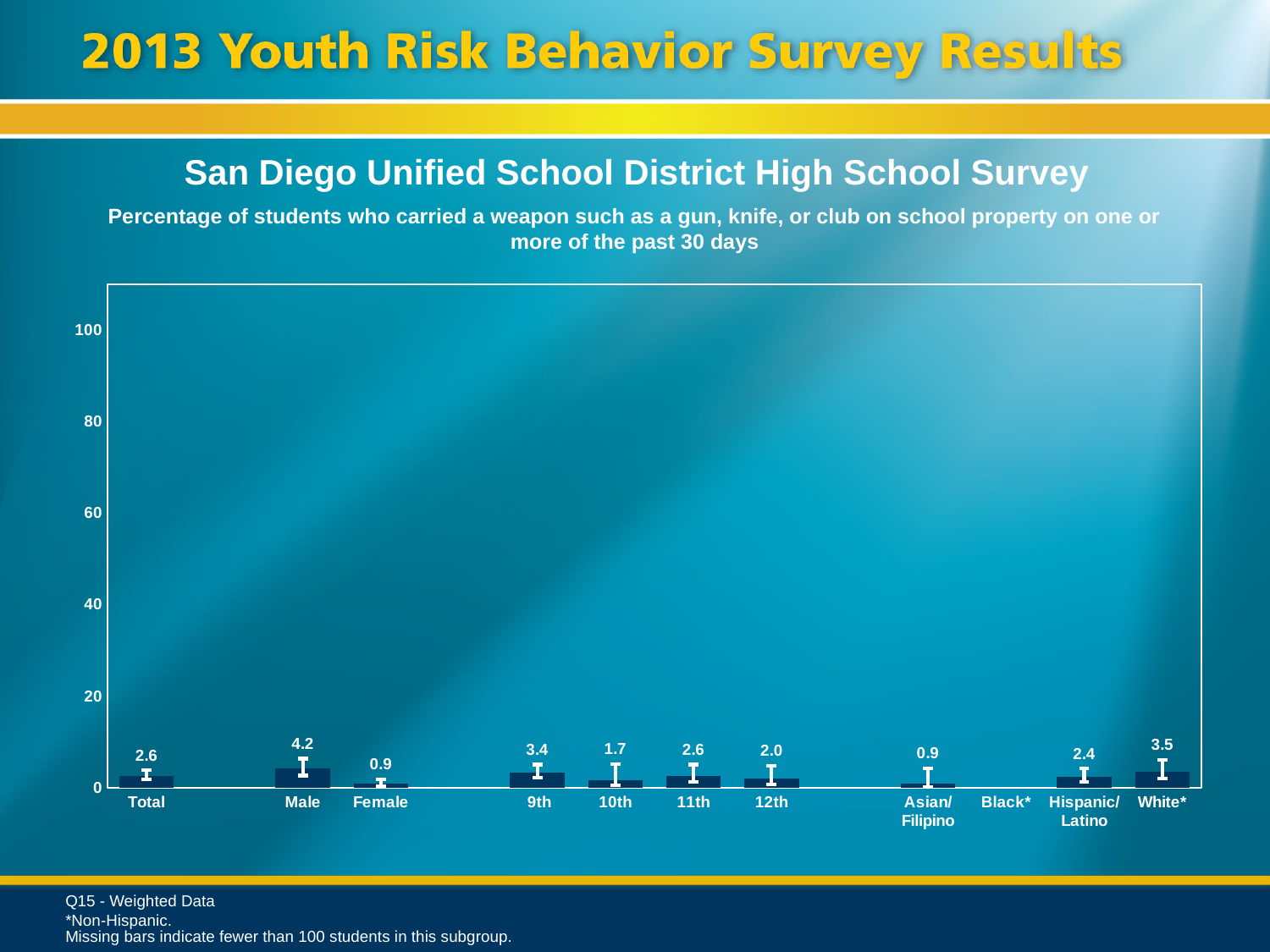
What is the difference between the values for Male and Female? 3.3 Among the grade levels (9th, 10th, 11th, 12th), which has the lowest value? 10th What is the value for 9th grade? 3.4 What is the value for Male? 4.2 Which category has the highest value? Male What kind of chart is shown on the slide? bar chart Which category on the x axis has no bar plotted? Black* Is the value for Total greater or less than 20? less What is the difference between the values for White* and Hispanic/Latino? 1.1 What is the value for Total? 2.6 Which is larger, the value for 9th or the value for 12th? 9th What is the value for Asian/Filipino? 0.9